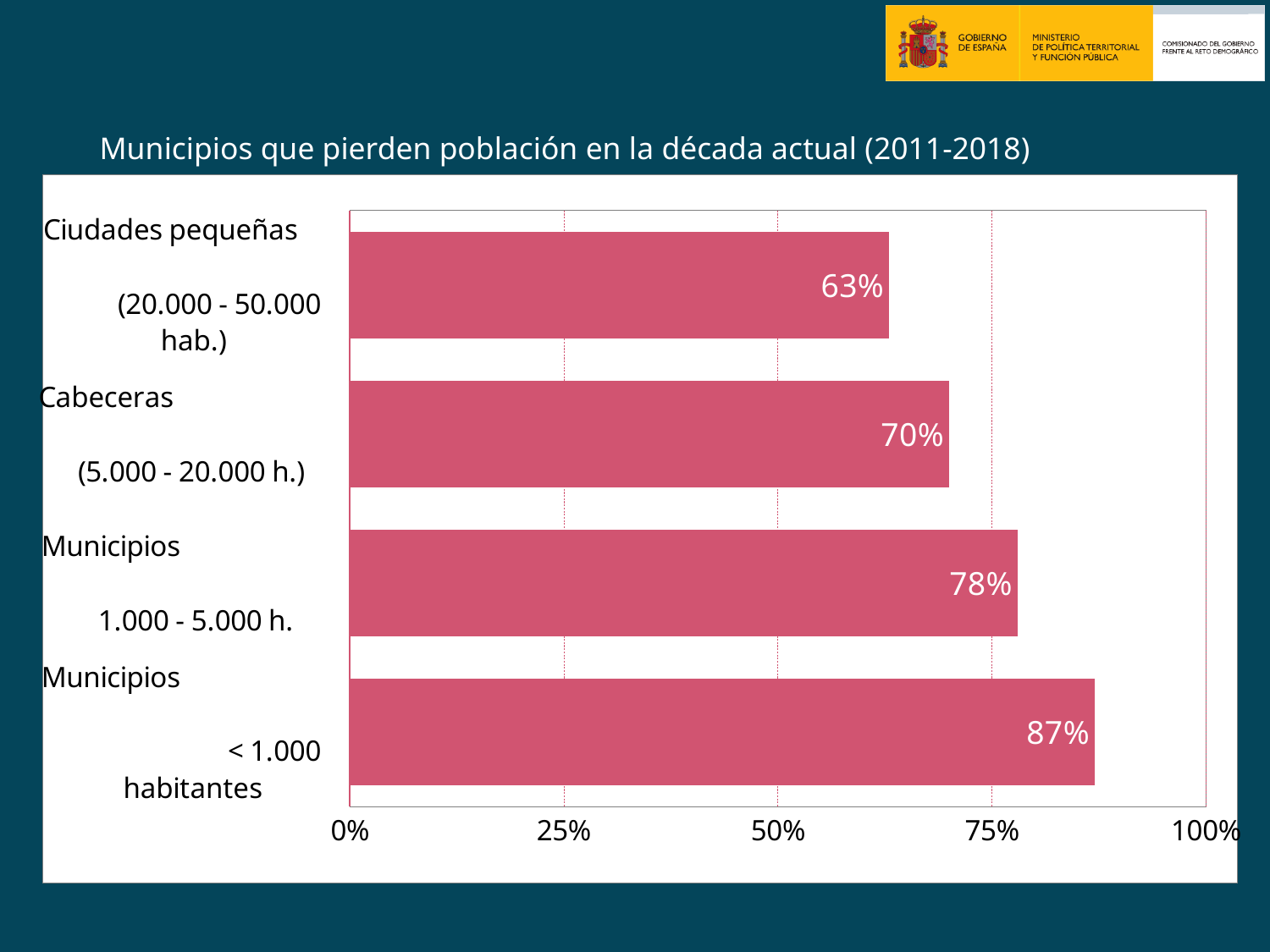
What is the value shown for Cabeceras (5.000 - 20.000 h.)? 70% Is the value for Ciudades pequeñas greater or less than 75%? less What percentage of municipalities with fewer than 1,000 inhabitants (Municipios < 1.000 habitantes) lost population? 87% What type of chart is shown on the slide? Bar chart What is the difference between the value for Municipios 1.000 - 5.000 h. and the value for Cabeceras? 8% Which category has the lowest percentage of municipalities losing population? Ciudades pequeñas (20.000 - 50.000 hab.) What is the difference between the value for Municipios < 1.000 habitantes and the value for Ciudades pequeñas? 24% Which is larger: the value for Cabeceras or the value for Municipios 1.000 - 5.000 h.? Municipios 1.000 - 5.000 h. What is the value shown for Ciudades pequeñas (20.000 - 50.000 hab.)? 63% Which category has the highest percentage of municipalities losing population? Municipios < 1.000 habitantes How many categories are shown in the chart? 4 What is the value shown for Municipios 1.000 - 5.000 h.? 78%